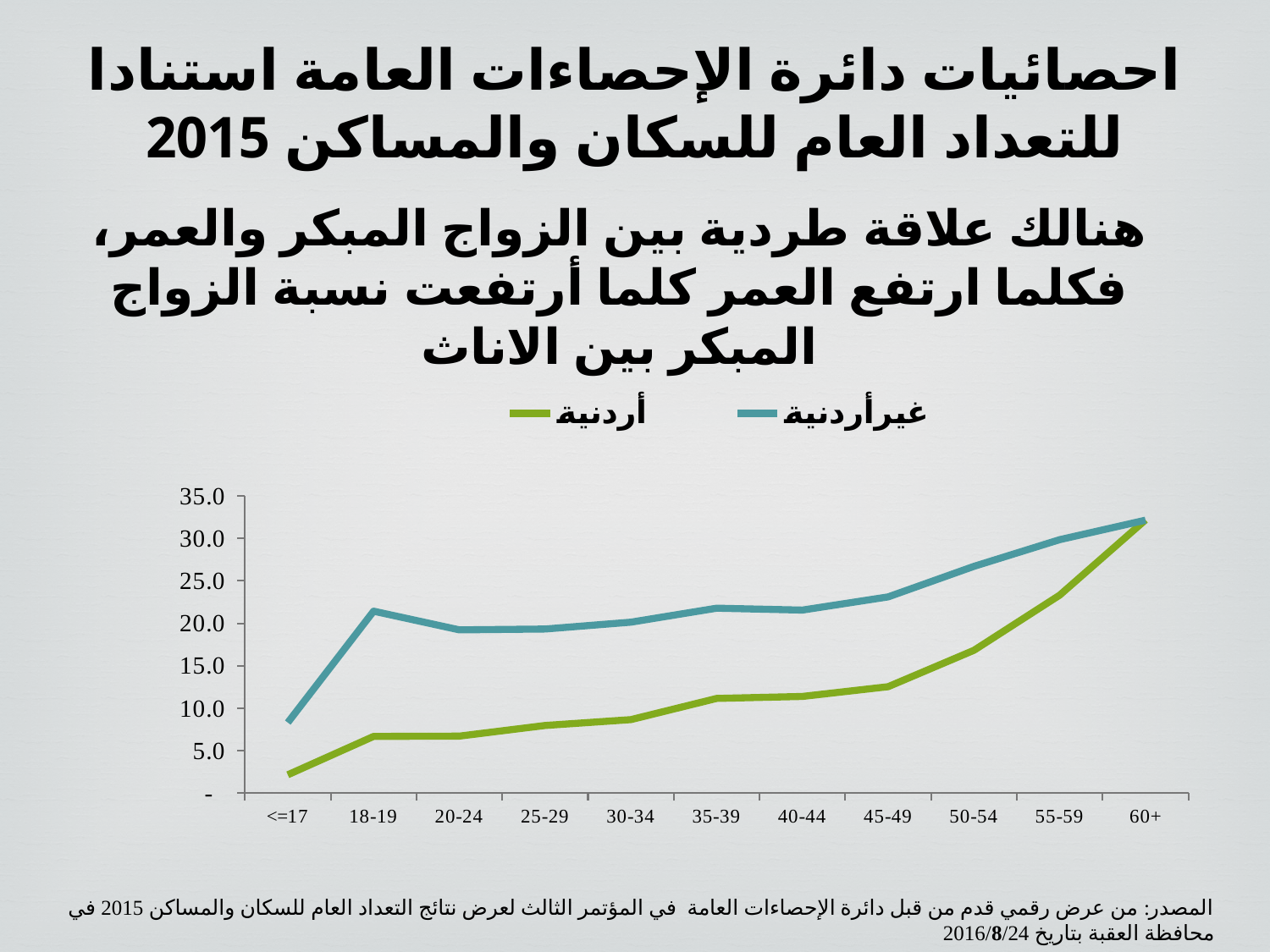
How many series does the legend list? 2 Which series is drawn in green? أردنية For which age category is the value of أردنية highest? 60+ Do the values for أردنية generally rise or fall as age increases along the x axis? rise How many age categories are shown on the x axis? 11 Is the value for أردنية at <=17 greater or less than 5.0? less At 35-39, which series has the larger value, أردنية or غيرأردنية? غيرأردنية Is the value for أردنية at 60+ greater or less than 30.0? greater Is the value for غيرأردنية at 18-19 greater or less than 20.0? greater For which age category is the value of غيرأردنية lowest? <=17 What kind of chart is shown on the slide? line chart